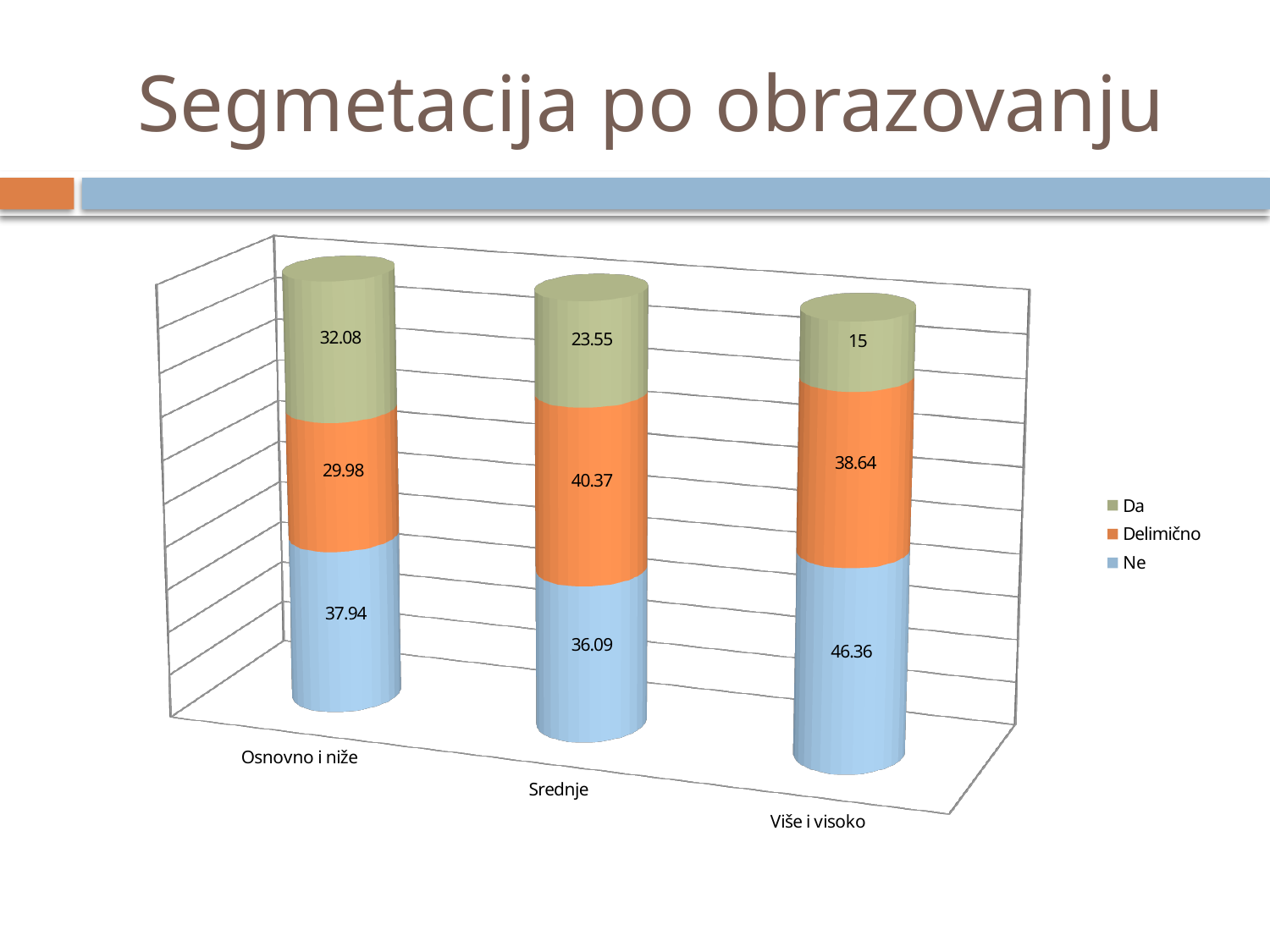
How many education categories are shown on the x axis? 3 Which category has the lowest value for the 'Ne' series? Srednje How many series does the legend list? 3 Which category has the highest value for the 'Da' series? Osnovno i niže What is the difference between the 'Delimično' values for 'Srednje' and 'Više i visoko'? 1.73 What kind of chart is shown on the slide? Stacked bar chart What is the value of the 'Da' series for 'Srednje'? 23.55 What is the value of the 'Ne' series for 'Više i visoko'? 46.36 What is the value of the 'Delimično' series for 'Osnovno i niže'? 29.98 What is the title of the slide containing the chart? Segmetacija po obrazovanju Which is larger: the 'Ne' value for 'Osnovno i niže' or the 'Ne' value for 'Srednje'? Osnovno i niže What is the total of the stacked bar for 'Više i visoko'? 100